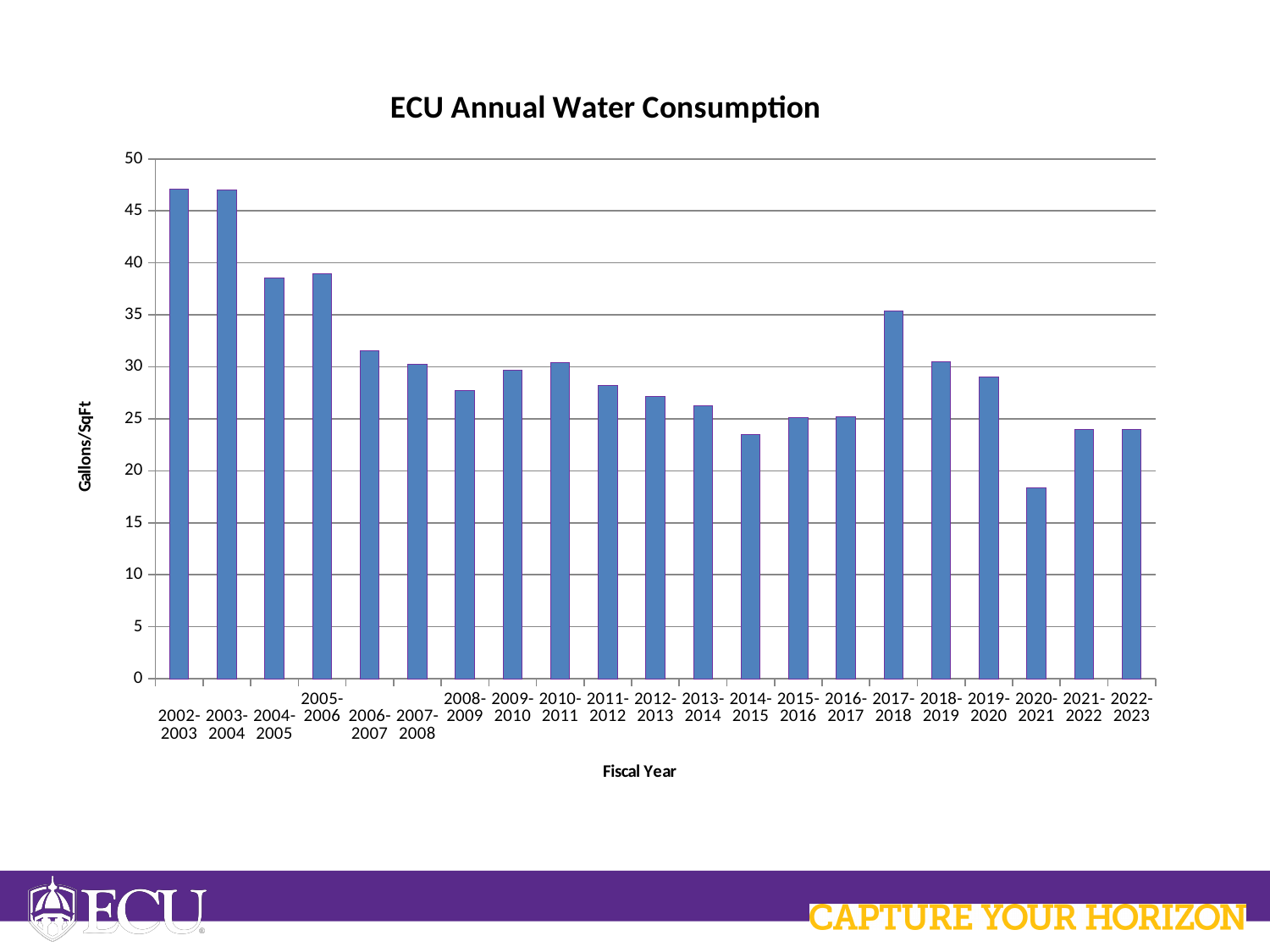
Is the value for 2004-2005 greater or less than 40? less Overall, do the values rise or fall from 2002-2003 to 2022-2023? fall Is the value for 2017-2018 greater or less than 30? greater Is the value for 2002-2003 greater or less than 45? greater Which fiscal year has the lowest water consumption? 2020-2021 What type of chart is shown on the slide? Bar chart What is the label on the vertical axis of the chart? Gallons/SqFt Which is larger, the value for 2017-2018 or the value for 2018-2019? 2017-2018 What is the title of the chart? ECU Annual Water Consumption How many fiscal years are plotted in the chart? 21